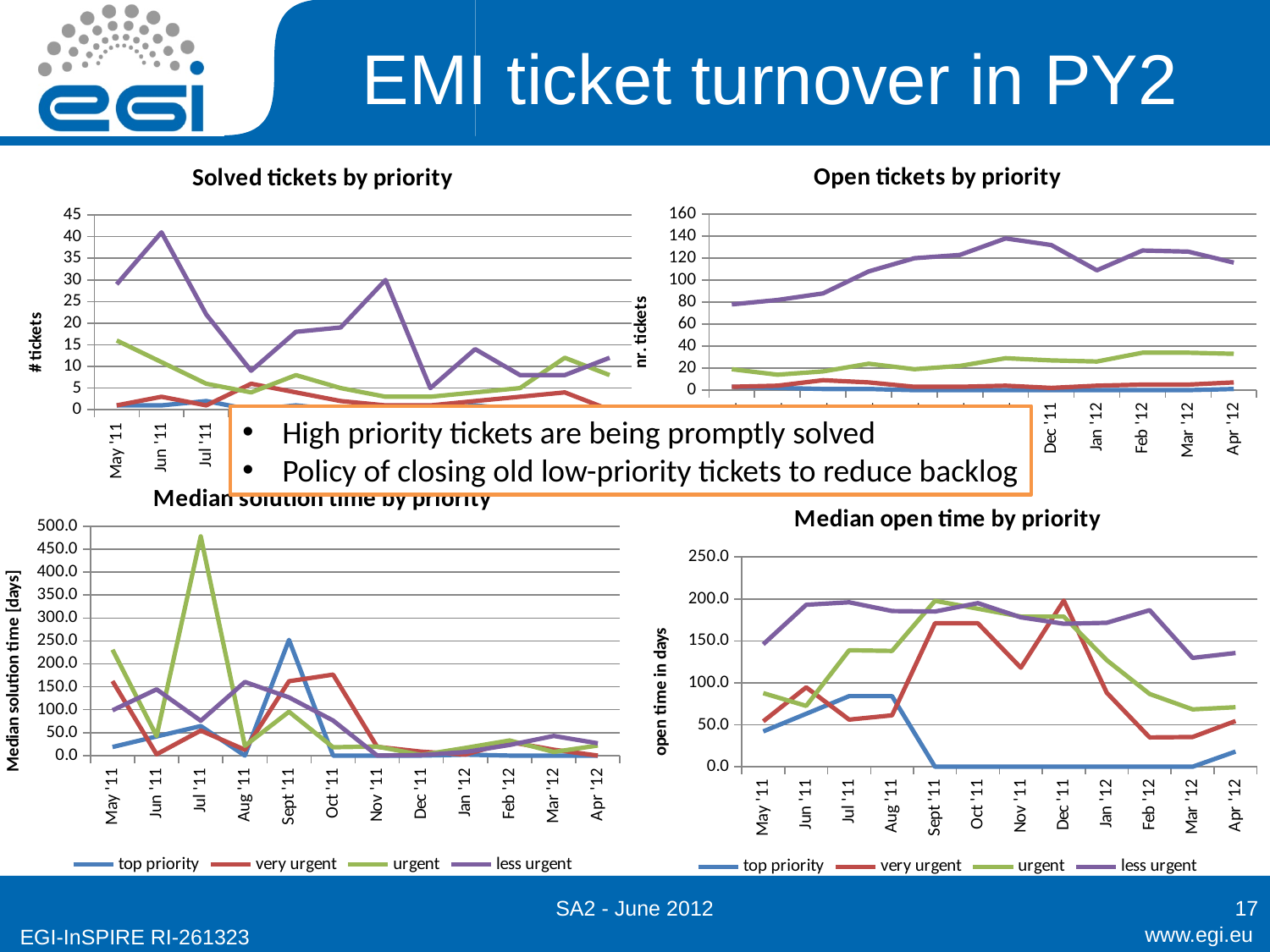
In the 'Median open time by priority' chart, what is the value for top priority at Oct '11? 0.0 What is the y-axis label of the 'Median open time by priority' chart? open time in days How many series does the legend of the 'Median open time by priority' chart list? 4 In the 'Median solution time by priority' chart, is the value for urgent at Jul '11 greater or less than 400? greater How many months are shown on the x axis of the 'Median solution time by priority' chart? 12 What kind of chart is the 'Median solution time by priority' chart? line chart In the 'Median solution time by priority' chart, is the value for top priority at Sept '11 greater or less than 200? greater In the 'Median open time by priority' chart, which is larger at Dec '11: very urgent or top priority? very urgent In the 'Median open time by priority' chart, is the value for very urgent at Feb '12 greater or less than 50? less In the 'Open tickets by priority' chart, does the top (purple) line rise or fall from May '11 to Nov '11? rise In the 'Median solution time by priority' chart, which series reaches the highest peak? urgent